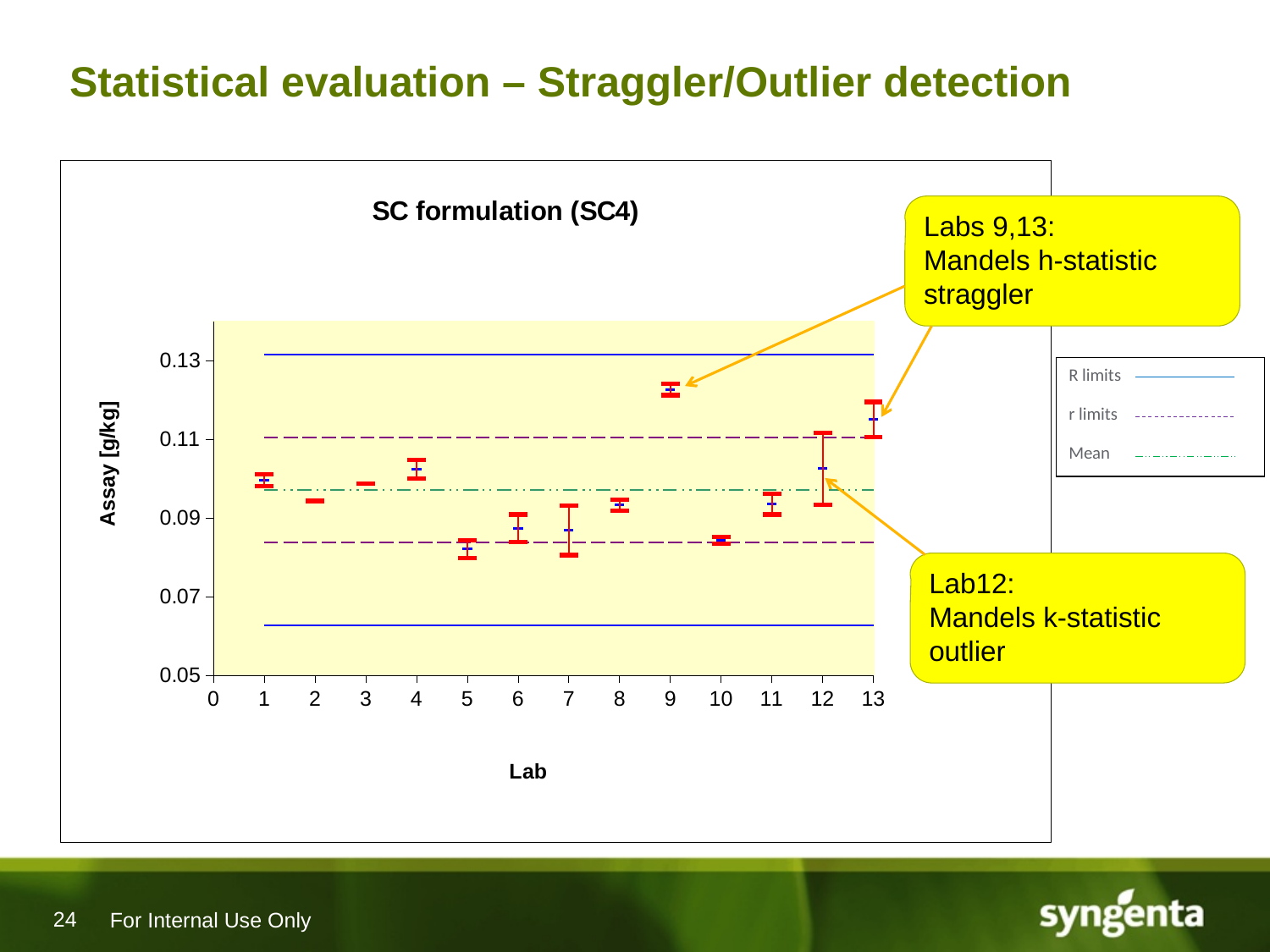
What is the title of the chart? SC formulation (SC4) Which lab has the highest mean assay value on the chart? Lab 9 What is the label of the y axis of the chart? Assay [g/kg] How many labs are plotted on the chart? 13 Is the mean assay value for Lab 13 greater or less than 0.11? greater Which lab has a higher mean assay value, Lab 9 or Lab 13? Lab 9 How many entries does the chart legend list? 3 Is the mean assay value for Lab 9 greater or less than 0.11? greater Is the mean assay value for Lab 1 greater or less than 0.09? greater Which lab has a higher mean assay value, Lab 4 or Lab 2? Lab 4 Which lab shows the widest range (longest error bar) on the chart? Lab 12